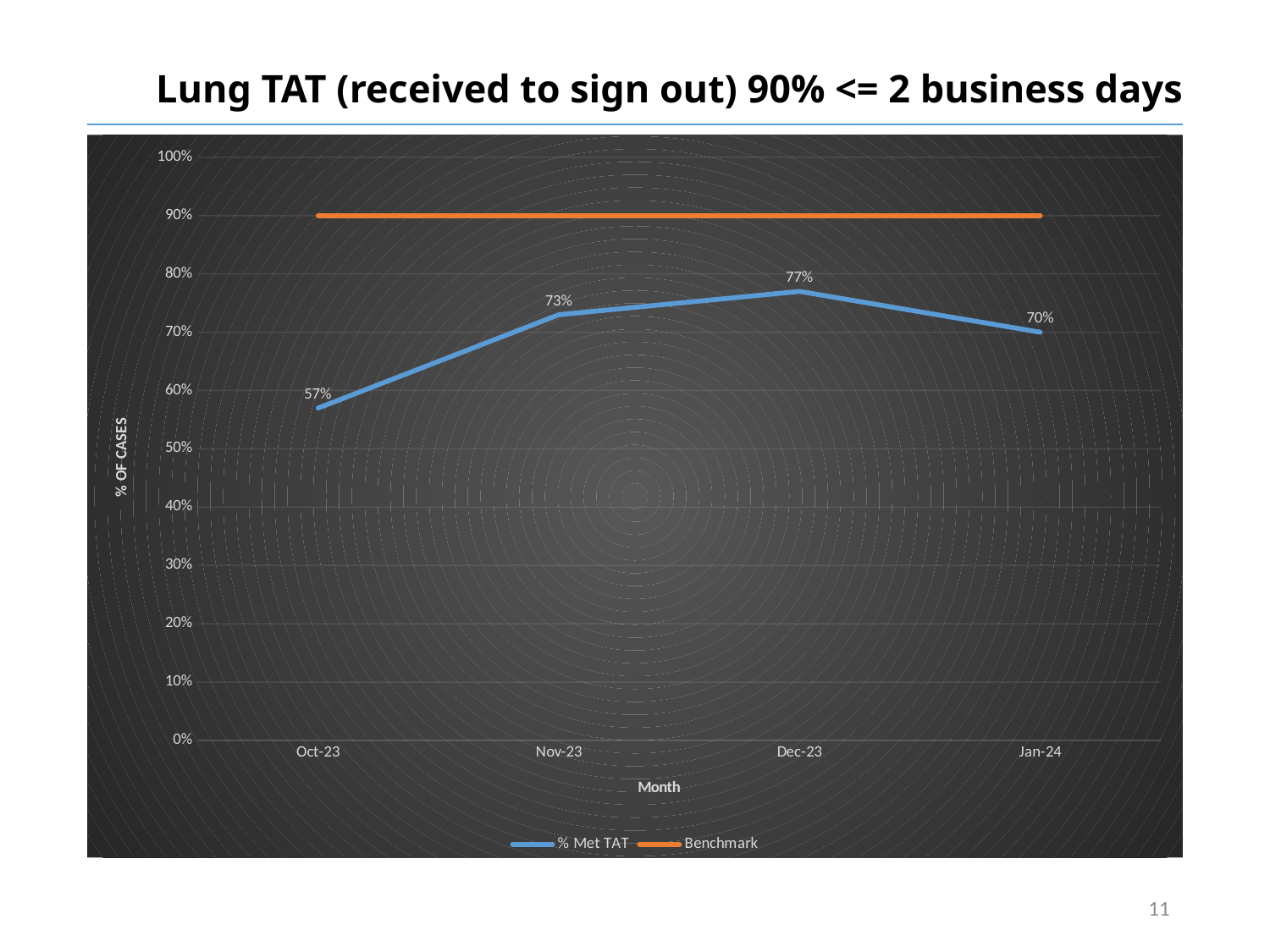
What kind of chart is shown on the slide? line chart Is the Benchmark line greater or less than 80%? greater Which month has the lowest % Met TAT? Oct-23 Which month has a higher % Met TAT, Nov-23 or Jan-24? Nov-23 How many series does the legend list? 2 What is the difference between the % Met TAT for Dec-23 and Oct-23? 20% What is the % Met TAT value for Jan-24? 70% Which month has the highest % Met TAT? Dec-23 What is the % Met TAT value for Oct-23? 57% What is the % Met TAT value for Dec-23? 77% How many months are plotted on the x axis? 4 What is the % Met TAT value for Nov-23? 73%